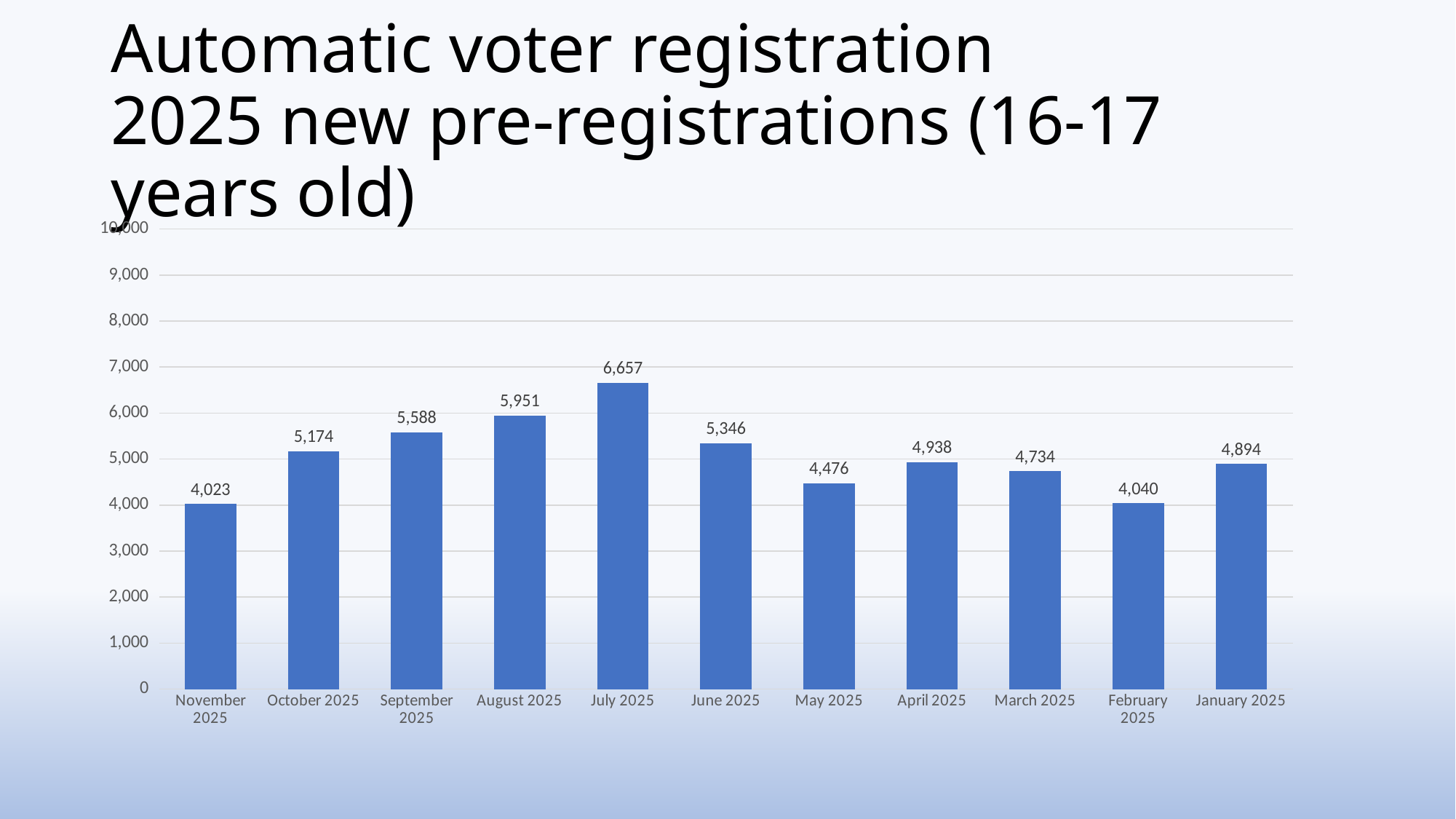
Is the value for August 2025 greater or less than 5,000? greater What is the difference between the values for February 2025 and November 2025? 17 How many months are shown on the x axis? 11 Which is larger, the value for October 2025 or the value for April 2025? October 2025 Which month has the lowest value? November 2025 Do the values rise or fall from November 2025 to July 2025 along the x axis? rise What is the value for July 2025? 6,657 What is the value for November 2025? 4,023 What is the difference between the values for July 2025 and June 2025? 1,311 What is the value for March 2025? 4,734 Which month has the highest value? July 2025 What kind of chart is shown on the slide? bar chart